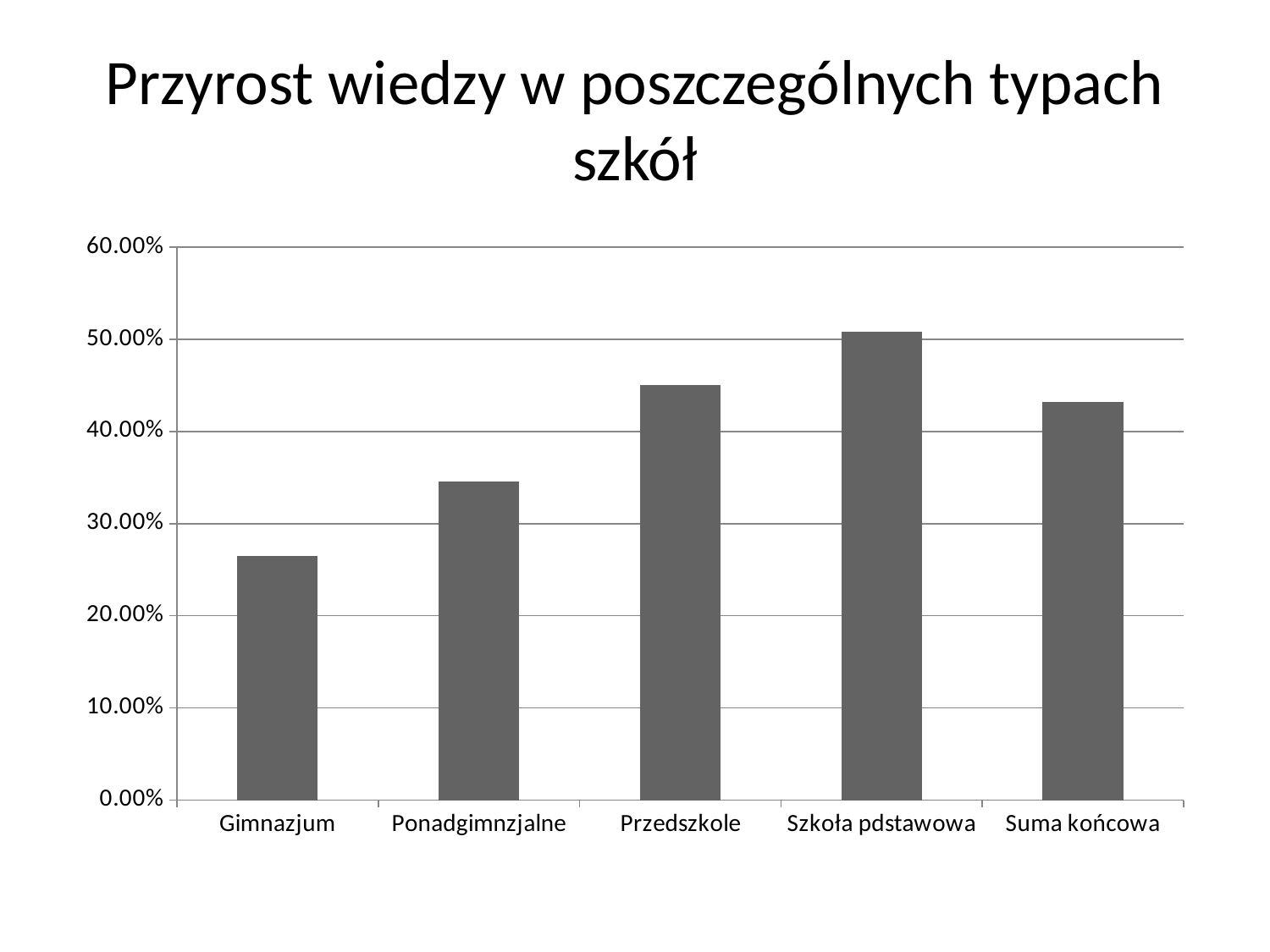
Which category has the lowest value? Gimnazjum How many categories are shown on the x axis of the chart? 5 Is the value for Ponadgimnzjalne greater or less than 40.00%? less What is the title of the chart? Przyrost wiedzy w poszczególnych typach szkół Which category has the highest value? Szkoła pdstawowa Is the value for Przedszkole greater or less than 40.00%? greater Is the value for Gimnazjum greater or less than 30.00%? less What type of chart is shown on the slide? bar chart Which is larger, the value for Suma końcowa or the value for Gimnazjum? Suma końcowa Which is larger, the value for Przedszkole or the value for Ponadgimnzjalne? Przedszkole